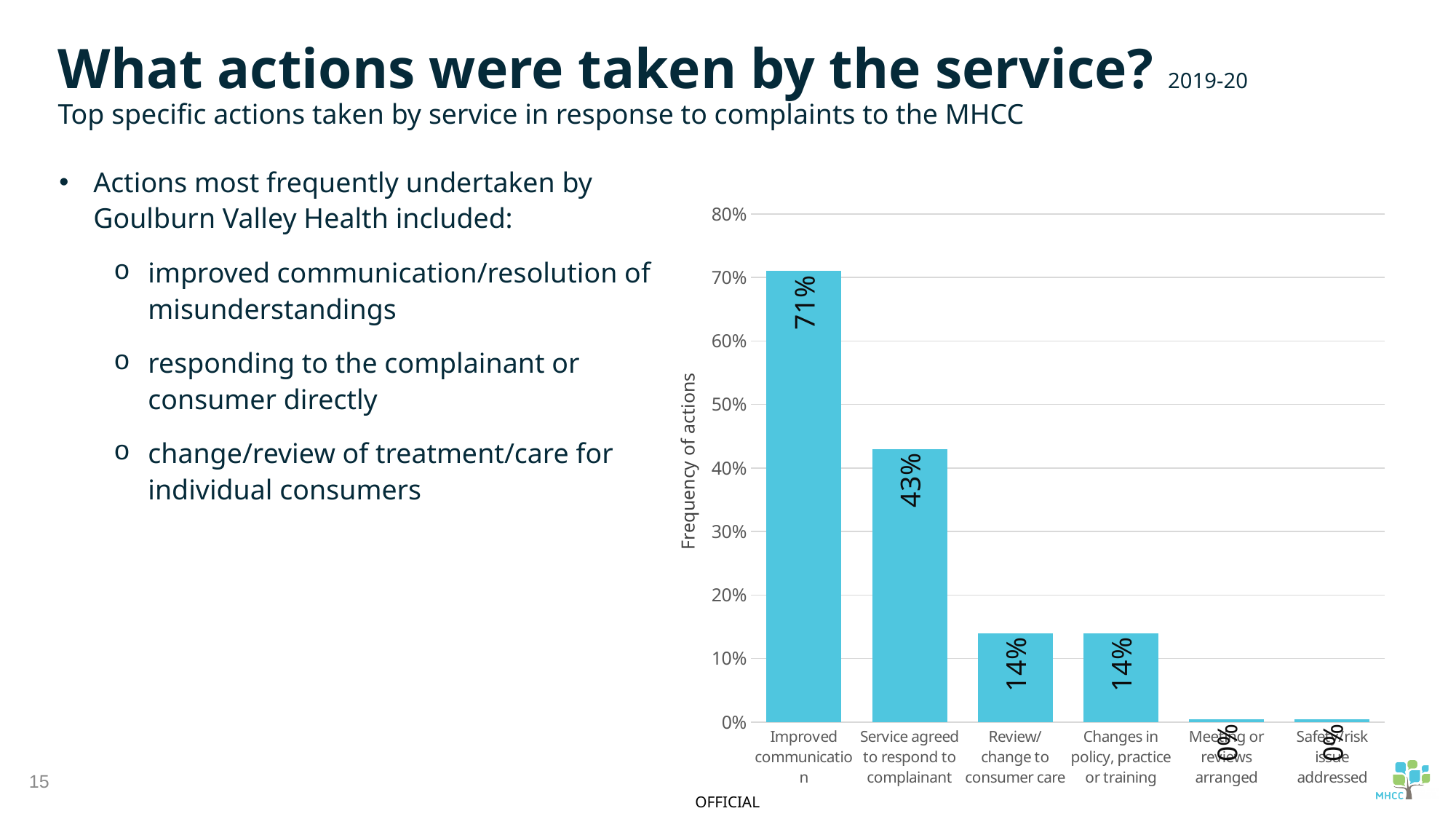
What kind of chart is shown on the slide? bar chart What is the label of the vertical axis? Frequency of actions What is the value for Meeting or reviews arranged? 0% What is the difference between the values for Improved communication and Service agreed to respond to complainant? 28% What is the value for Improved communication? 71% How many categories are shown on the x axis? 6 What is the value for Service agreed to respond to complainant? 43% Which category has the highest value? Improved communication Which is larger, the value for Service agreed to respond to complainant or the value for Review/change to consumer care? Service agreed to respond to complainant What is the difference between the values for Service agreed to respond to complainant and Review/change to consumer care? 29% What is the value for Changes in policy, practice or training? 14% Is the value for Improved communication greater or less than 60%? greater